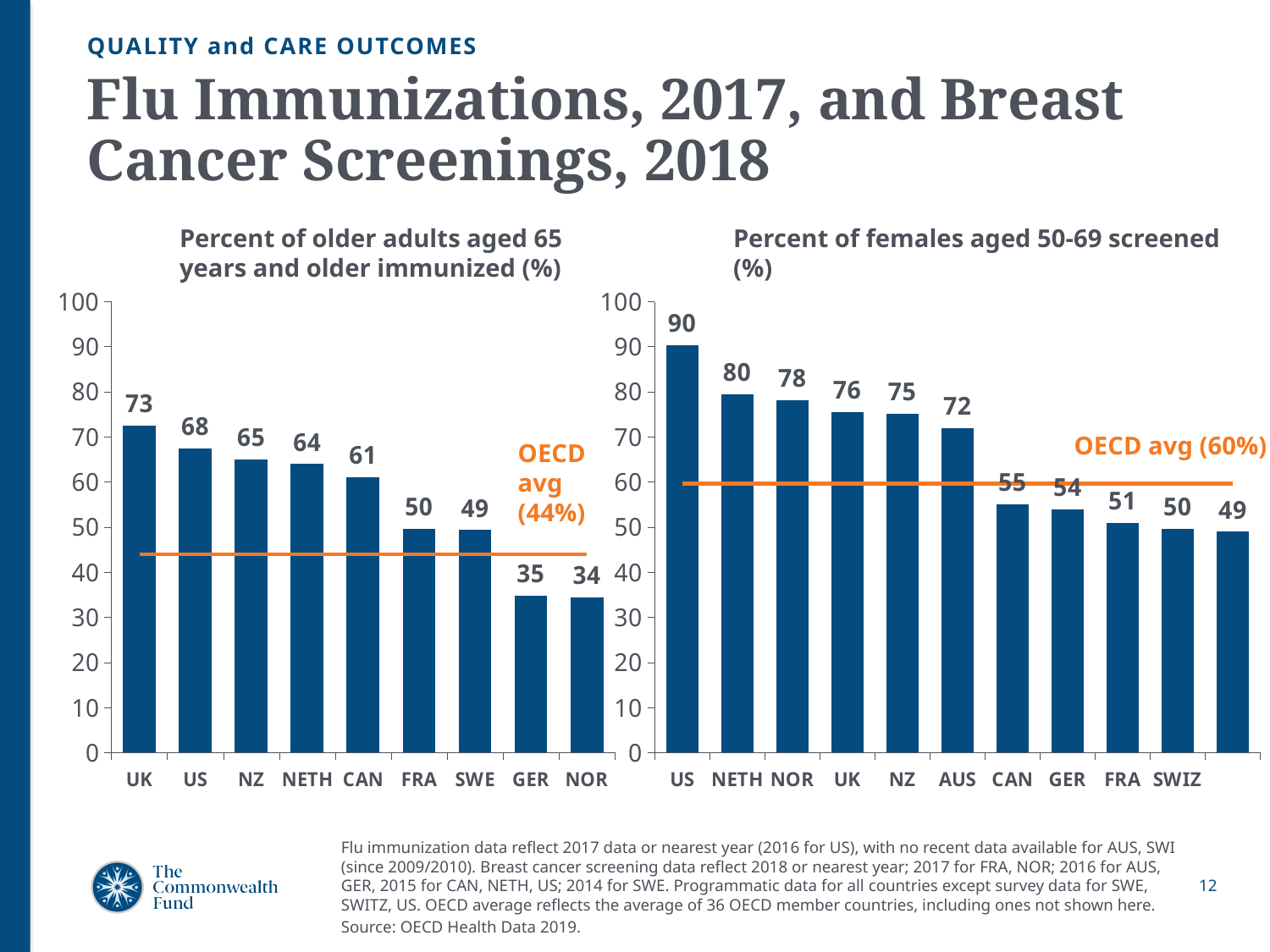
In the breast cancer screening chart (right), which is larger, the value for CAN or the value for FRA? CAN In the breast cancer screening chart (right), what is the value for NETH? 80 In the flu immunization chart (left), what OECD average is shown? 44% In the flu immunization chart (left), do the values rise or fall from left to right? Fall In the breast cancer screening chart (right), which country has the highest value? US In the flu immunization chart (left), which country has the lowest value? NOR In the flu immunization chart (left), what is the difference between the values for the UK and GER? 38 What kind of chart is the breast cancer screening chart (right)? Bar chart In the flu immunization chart (left), how many countries are shown? 9 In the breast cancer screening chart (right), what is the difference between the values for US and SWIZ? 40 In the breast cancer screening chart (right), how many countries are shown? 10 In the flu immunization chart (left), what is the value for the UK? 73